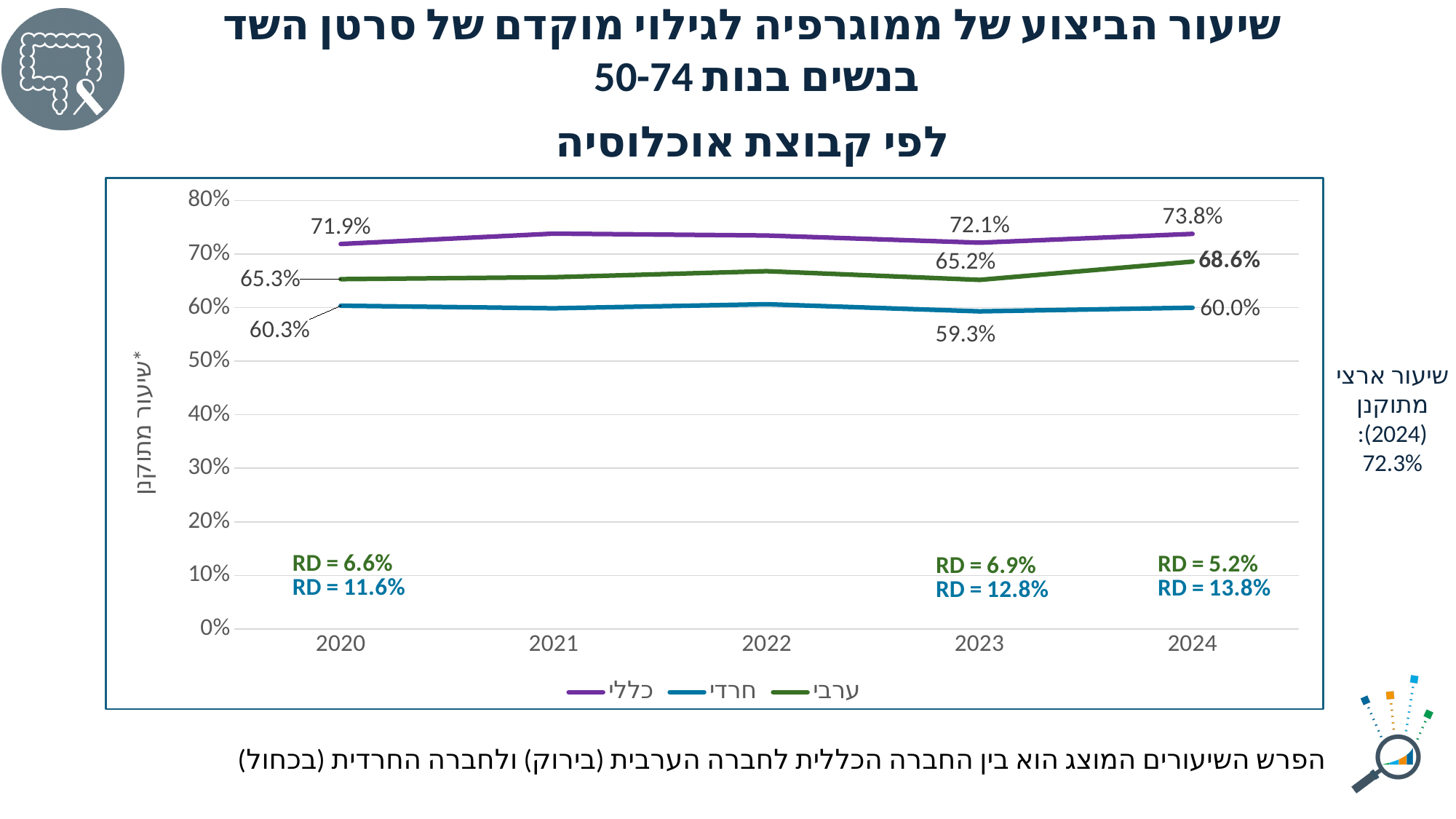
What is the value for the חרדי series in 2023? 59.3% Is the value for the ערבי series in 2022 greater or less than 60%? greater What is the value for the כללי series in 2024? 73.8% Which is larger, the ערבי value in 2023 or the ערבי value in 2024? 2024 Which series has the lowest value in 2024? חרדי What is the value for the חרדי series in 2024? 60.0% Which series has the highest value in 2020? כללי How many years are shown on the x axis? 5 What is the value for the ערבי series in 2020? 65.3% What is the difference between the כללי and ערבי values in 2024? 5.2% What type of chart is shown on the slide? line chart How many series does the legend list? 3